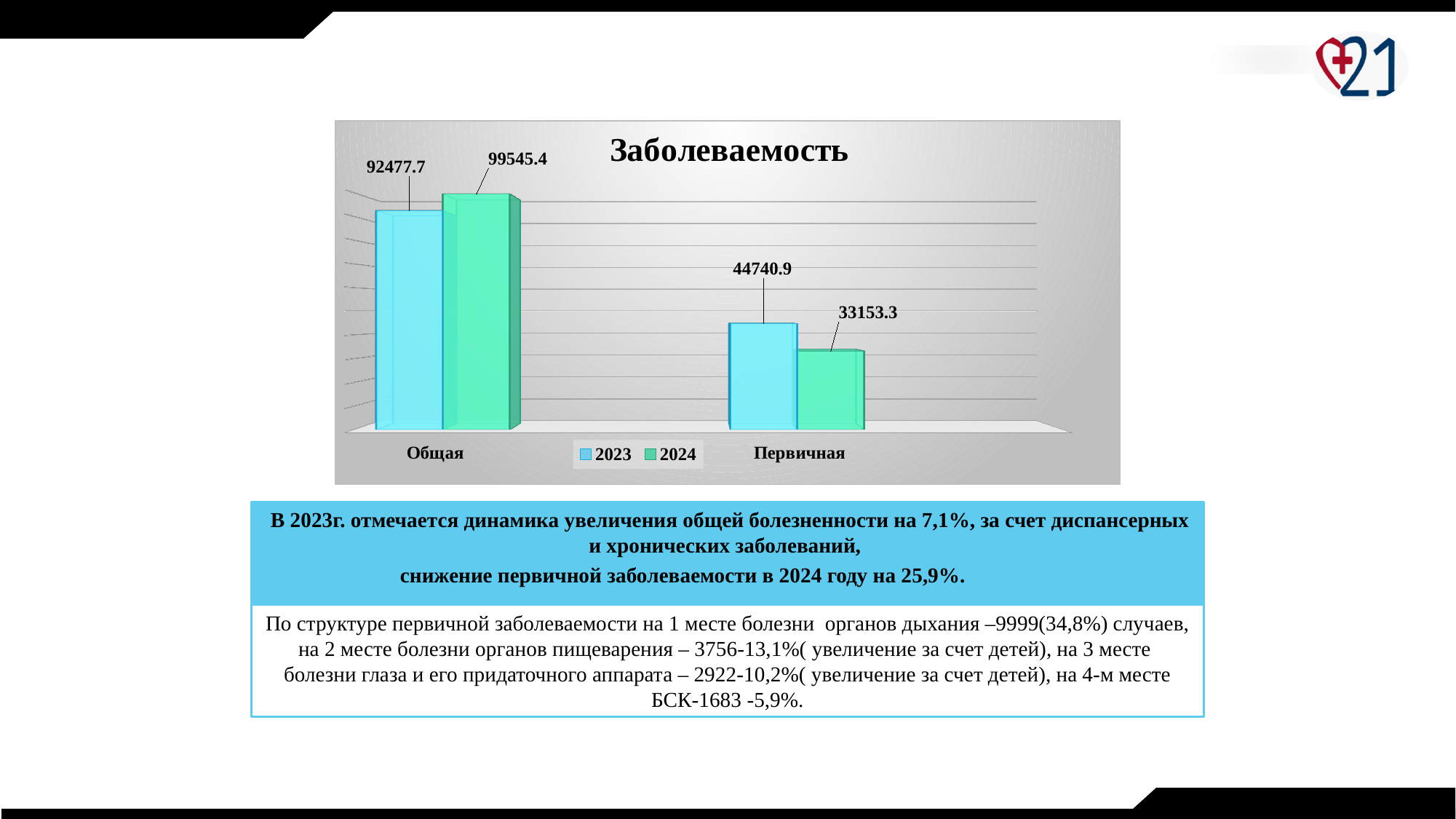
What is the difference between the 2023 and 2024 values for Первичная? 11587.6 For Первичная, which year has the larger value, 2023 or 2024? 2023 What is the value for Общая in 2024? 99545.4 How many categories are shown on the x axis? 2 Which bar has the highest value on the chart? Общая, 2024 Which bar has the lowest value on the chart? Первичная, 2024 What is the value for Общая in 2023? 92477.7 What is the value for Первичная in 2023? 44740.9 How many series does the legend list? 2 What type of chart is shown on the slide? Bar chart What is the value for Первичная in 2024? 33153.3 What is the difference between the 2024 and 2023 values for Общая? 7067.7